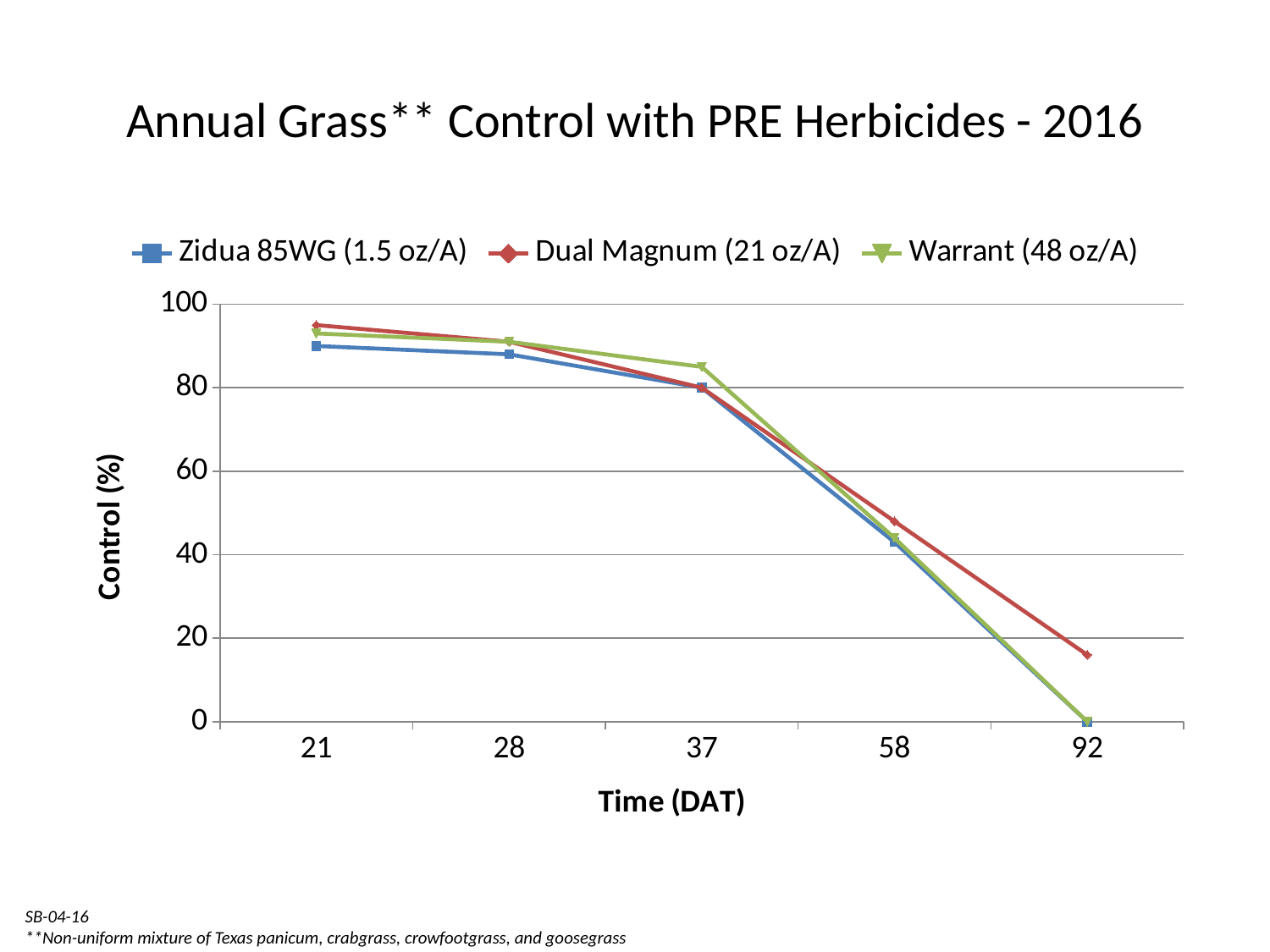
What is the control value for Zidua 85WG (1.5 oz/A) at 92 DAT? 0 How many series does the legend list? 3 What is the title of the y axis? Control (%) At 21 DAT, which has the higher control value: Zidua 85WG (1.5 oz/A) or Dual Magnum (21 oz/A)? Dual Magnum (21 oz/A) Is the control value for Dual Magnum (21 oz/A) at 92 DAT greater or less than 20? less What is the control value for Dual Magnum (21 oz/A) at 37 DAT? 80 How many time points (DAT) are plotted along the x axis? 5 Which series has the highest control value at 92 DAT? Dual Magnum (21 oz/A) Is the control value for Zidua 85WG (1.5 oz/A) at 58 DAT greater or less than 60? less What kind of chart is shown on the slide? line chart Do the control values rise or fall as time (DAT) increases? fall Is the control value for Dual Magnum (21 oz/A) at 58 DAT greater or less than 40? greater